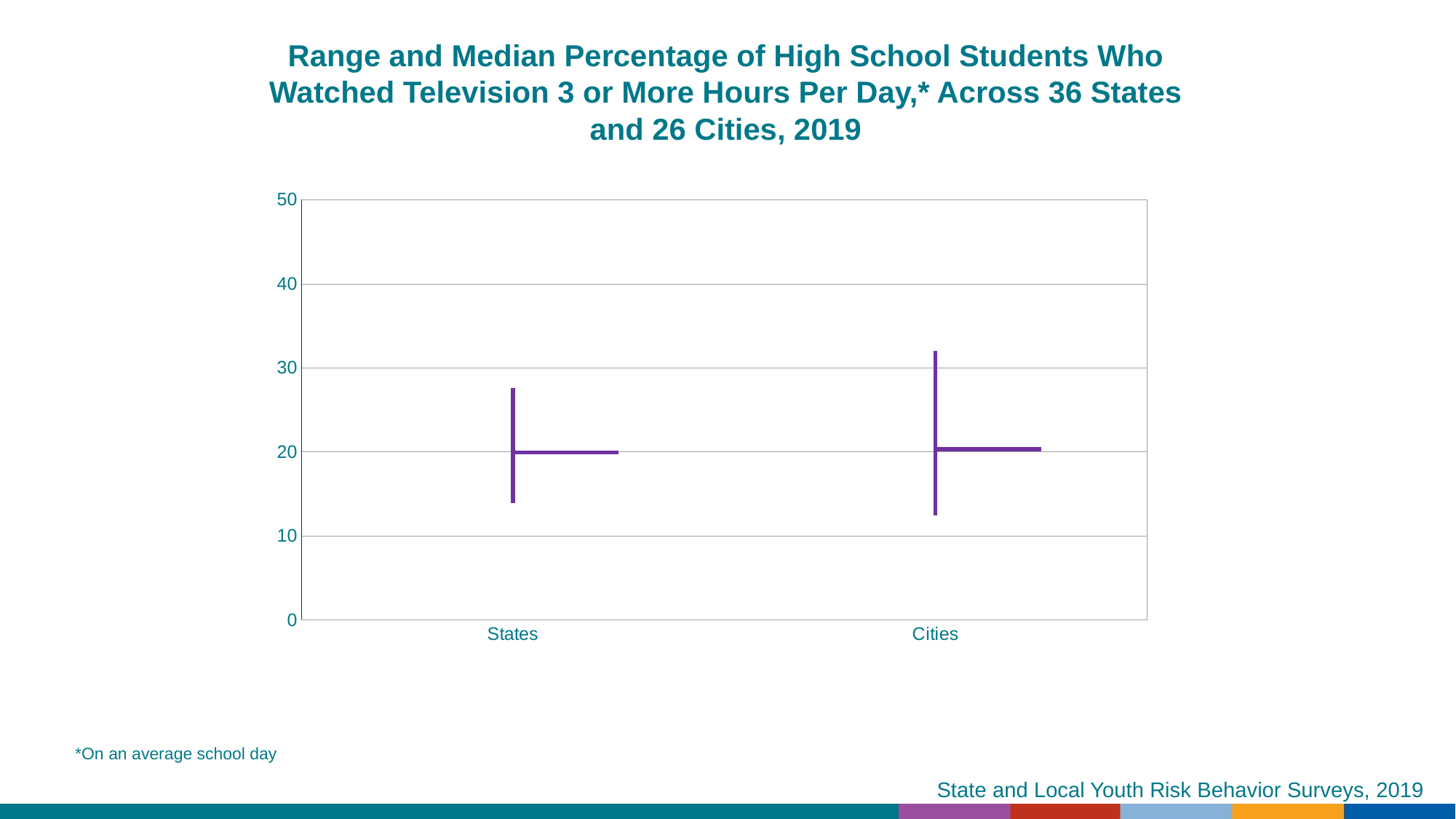
What are the two categories shown on the x axis? States and Cities How many categories are shown on the x axis of the chart? 2 What is the highest value shown on the y axis? 50 Is the median for States greater or less than 30? less Which category has the lower bottom of its range, States or Cities? Cities Is the bottom of the range for Cities greater or less than 10? greater What does the asterisk footnote on the slide say? On an average school day Is the top of the range for Cities greater or less than 30? greater Which category shows the wider range of values? Cities Which category has the higher top of its range, States or Cities? Cities